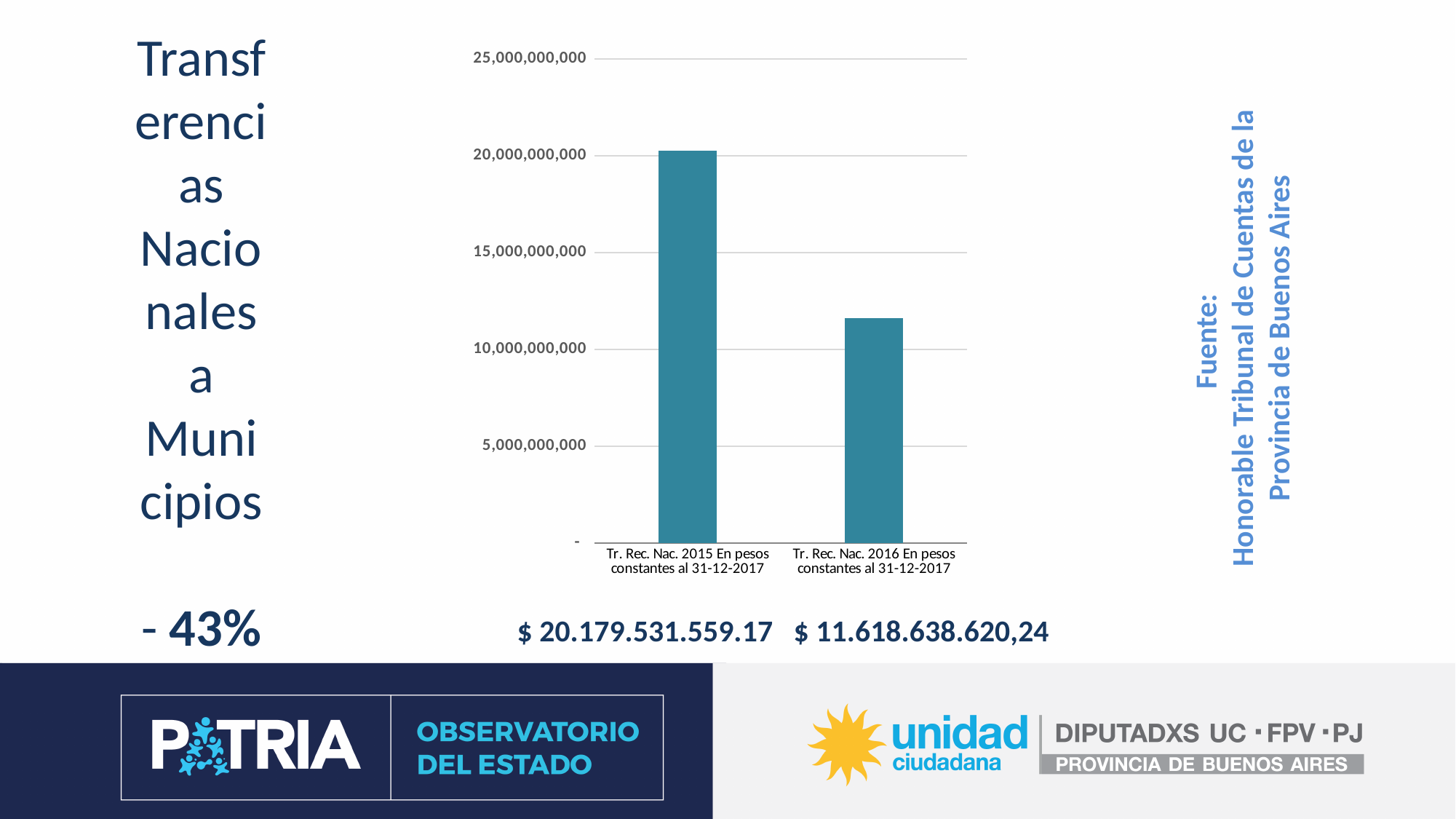
Is the bar for Tr. Rec. Nac. 2015 larger or smaller than the bar for Tr. Rec. Nac. 2016? larger Which category has the lowest bar? Tr. Rec. Nac. 2016 En pesos constantes al 31-12-2017 What kind of chart is shown on the slide? bar chart How many bars does the chart have? 2 Is the value for Tr. Rec. Nac. 2016 greater or less than 10,000,000,000? greater What value is printed below the chart for Tr. Rec. Nac. 2016? $ 11.618.638.620,24 What value is printed below the chart for Tr. Rec. Nac. 2015? $ 20.179.531.559.17 Do the values rise or fall from 2015 to 2016? fall Which category has the highest bar? Tr. Rec. Nac. 2015 En pesos constantes al 31-12-2017 Is the value for Tr. Rec. Nac. 2016 greater or less than 15,000,000,000? less What percentage change is printed on the left of the slide? - 43% Is the value for Tr. Rec. Nac. 2015 greater or less than 15,000,000,000? greater